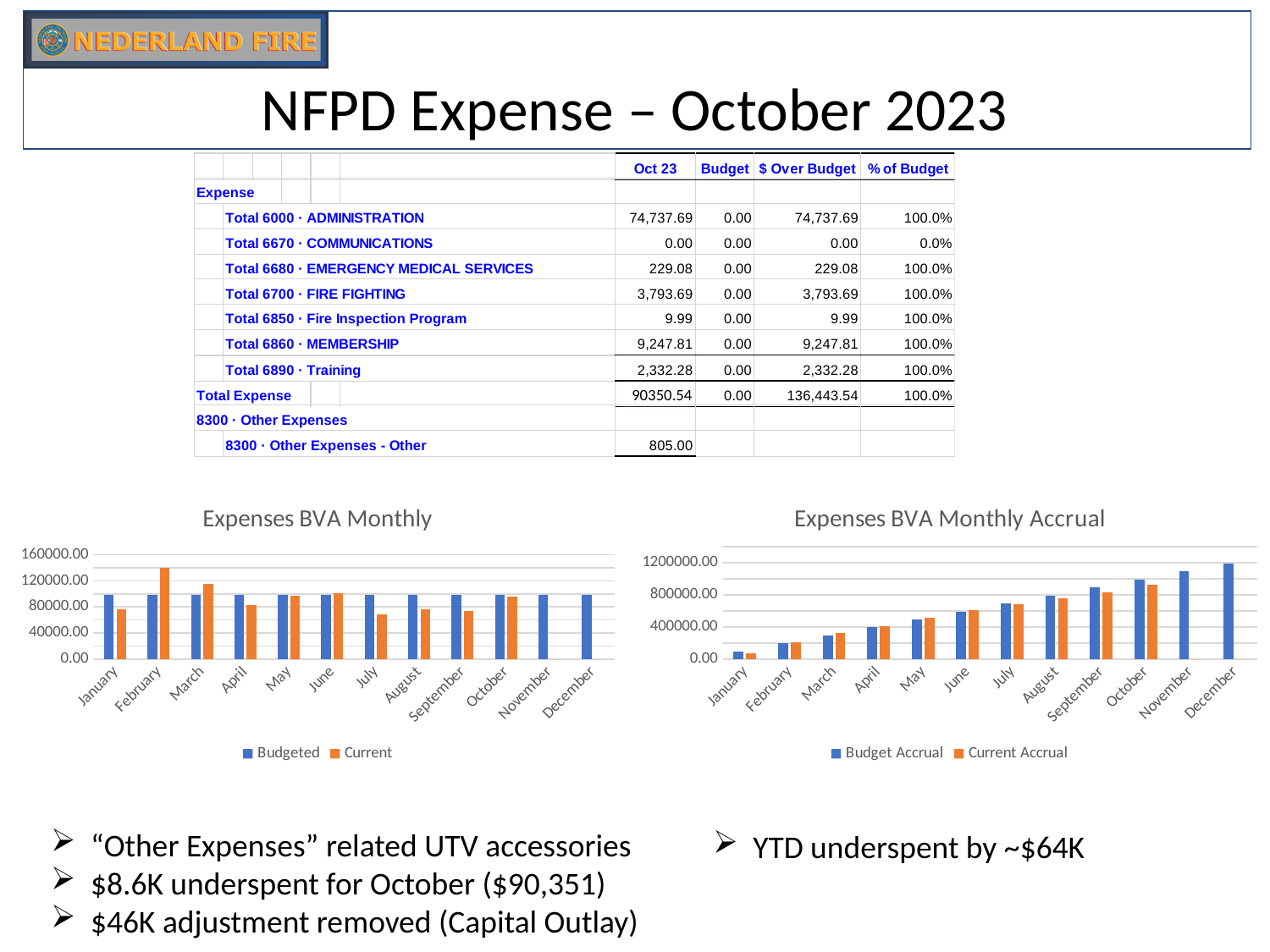
How many months are shown on the x axis of the "Expenses BVA Monthly" chart? 12 In the "Expenses BVA Monthly" chart, is the Current value for July greater or less than 80000? less How many series does the legend of the "Expenses BVA Monthly Accrual" chart list? 2 In the "Expenses BVA Monthly" chart, which is larger for July, Budgeted or Current? Budgeted In the "Expenses BVA Monthly Accrual" chart, do the Budget Accrual values rise or fall from January to December? rise What kind of chart is the "Expenses BVA Monthly" chart? bar chart In the "Expenses BVA Monthly" chart, which is larger for February, Budgeted or Current? Current In the "Expenses BVA Monthly" chart, is the Current value for February greater or less than 120000? greater In the "Expenses BVA Monthly" chart, which month has the highest Current value? February In the "Expenses BVA Monthly Accrual" chart, is the Current Accrual value for October greater or less than 800000? greater What are the two legend entries of the "Expenses BVA Monthly Accrual" chart? Budget Accrual and Current Accrual In the "Expenses BVA Monthly Accrual" chart, which month has the highest Budget Accrual value? December